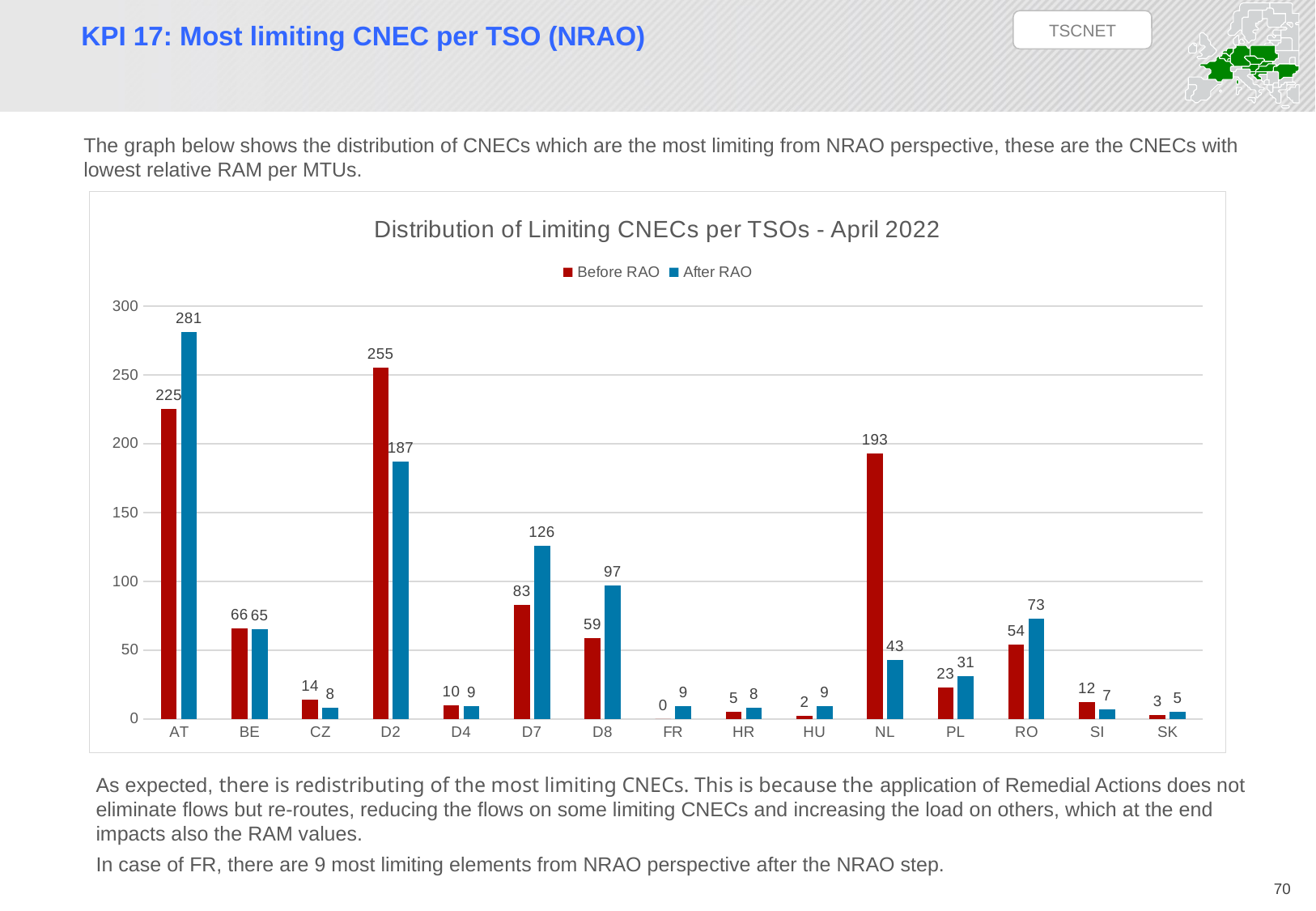
What is the Before RAO value for D2? 255 What kind of chart is shown? Bar chart How many series does the legend list? 2 What is the total of the Before RAO and After RAO values for RO? 127 What is the difference between the Before RAO and After RAO values for NL? 150 What is the After RAO value for NL? 43 Which TSO has the highest After RAO value? AT What is the title of the chart? Distribution of Limiting CNECs per TSOs - April 2022 Which TSO has the lowest Before RAO value? FR Which is larger for D7, the Before RAO value or the After RAO value? After RAO How many TSO categories are shown on the x axis? 15 What is the After RAO value for AT? 281